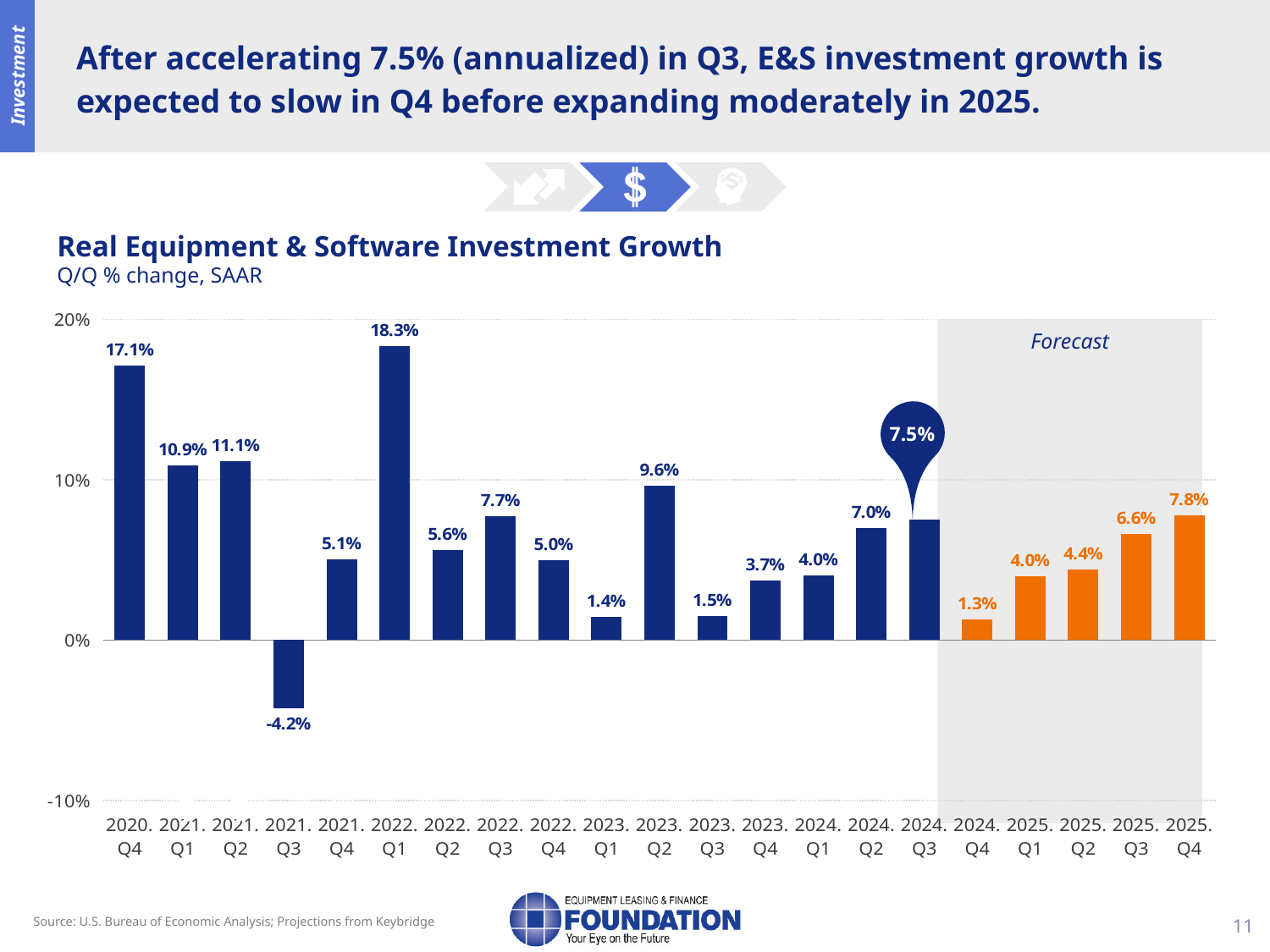
What is the value for 2024 Q3? 7.5% What kind of chart is this? Bar chart What is the difference between the values for 2024 Q3 and 2024 Q4? 6.2% What is the subtitle shown under the chart title? Q/Q % change, SAAR Which quarter has the lowest value? 2021 Q3 Do the forecast values rise or fall from 2024 Q4 to 2025 Q4? Rise Which is larger, the value for 2023 Q2 or the value for 2022 Q3? 2023 Q2 Which quarter has the highest value? 2022 Q1 Is the value for 2020 Q4 greater or less than 10%? greater What is the forecast value for 2025 Q4? 7.8% What is the value for 2022 Q1? 18.3% How many quarters are shown on the x axis? 21